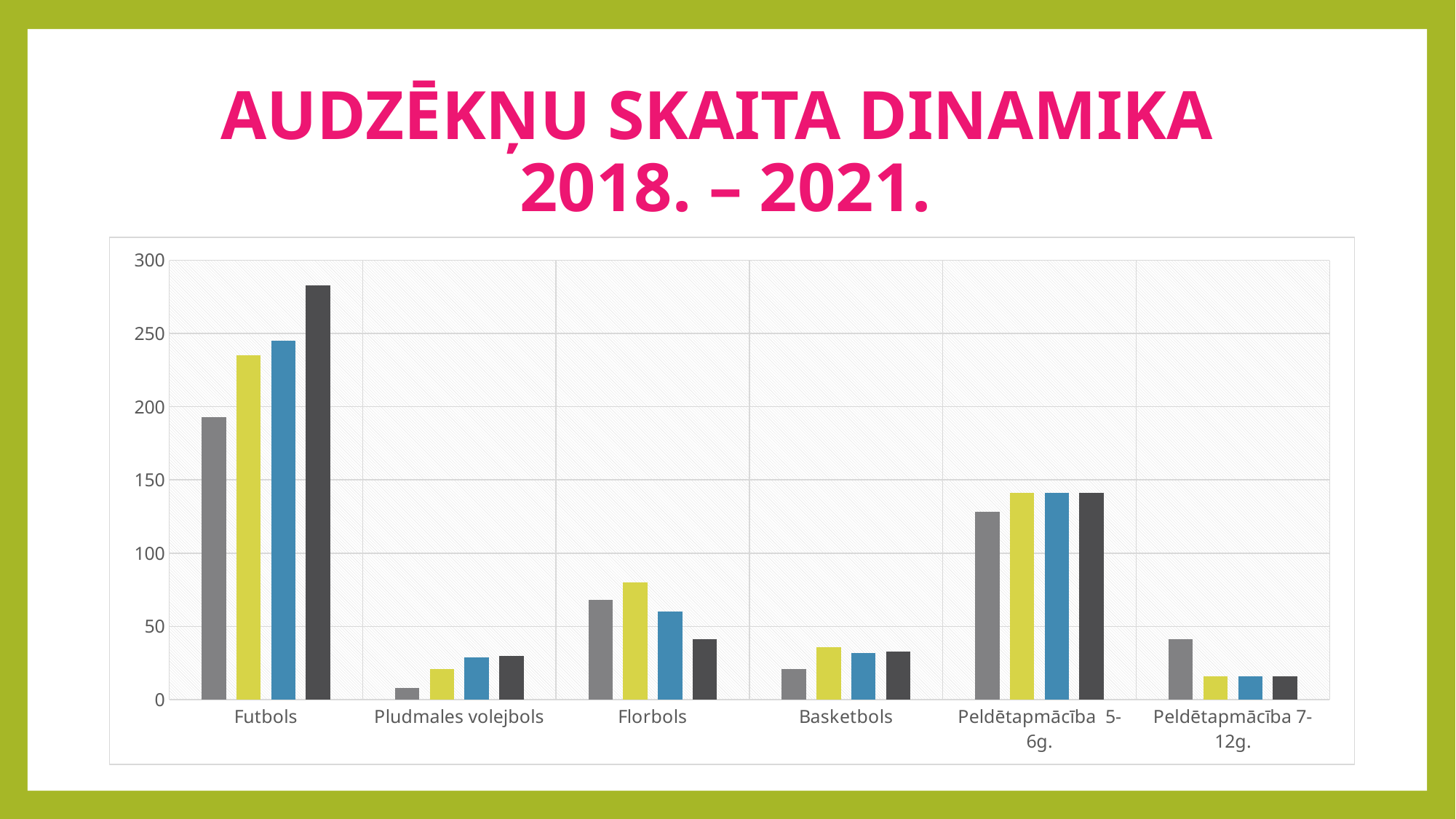
Which category has higher values, Florbols or Peldētapmācība 5-6g.? Peldētapmācība 5-6g. How many categories are shown on the x axis of the chart? 6 Is the tallest bar for Futbols greater or less than 250? greater What is the title of the slide above the chart? AUDZĒKŅU SKAITA DINAMIKA 2018. – 2021. Are the values for Pludmales volejbols greater or less than 50? less Do the four bars for Futbols rise or fall from left to right? rise Which category has the highest value in the chart? Futbols How many bars are plotted for each category in the chart? 4 Which category contains the lowest bar in the chart? Pludmales volejbols Are the values for Basketbols greater or less than 50? less What kind of chart is shown on the slide? bar chart